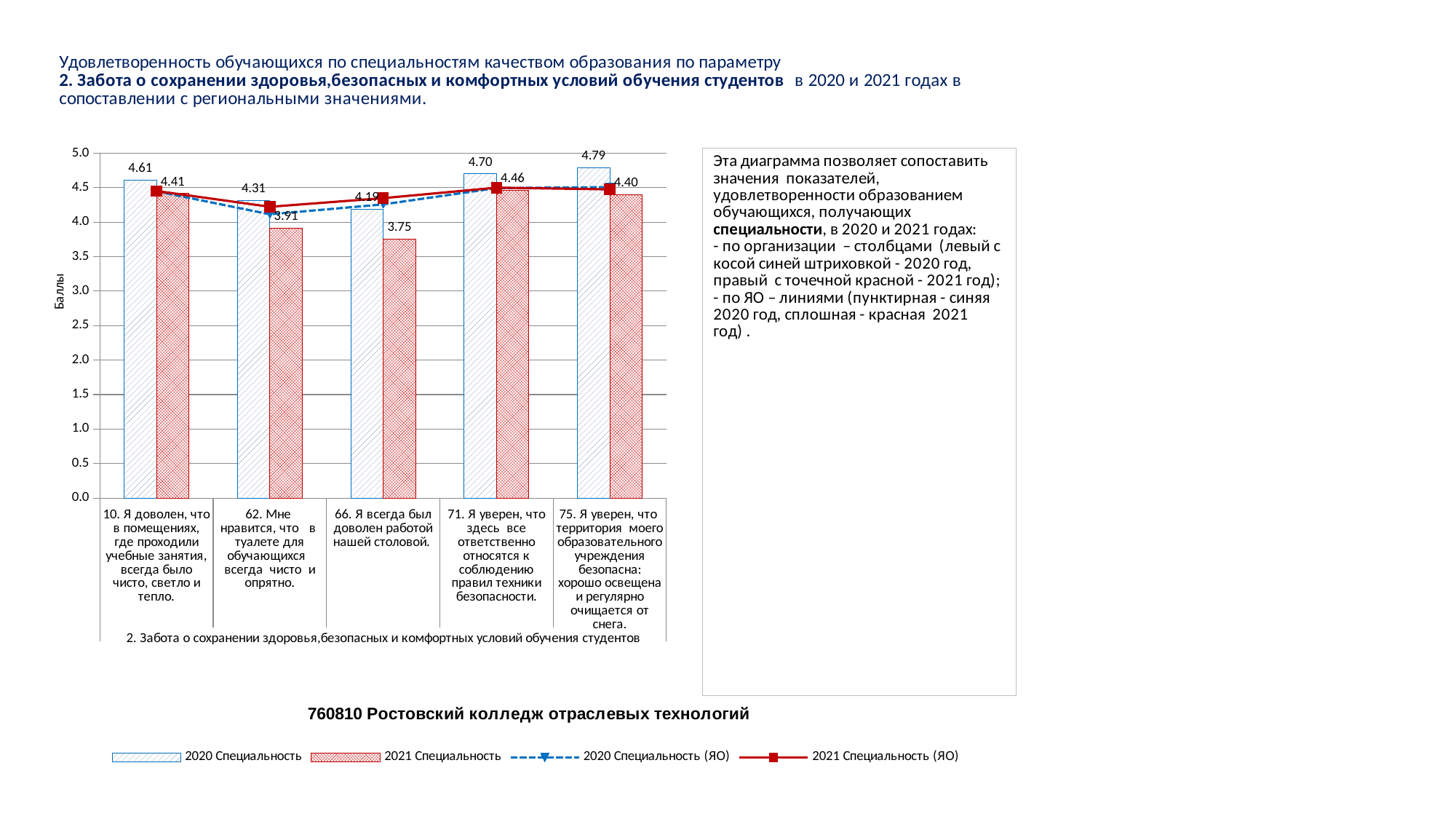
What is the label of the y axis? Баллы Which is larger for category 71: the 2020 Специальность value or the 2021 Специальность value? 2020 Специальность (4.70) Which category has the highest 2020 Специальность bar? 75. Я уверен, что территория моего образовательного учреждения безопасна: хорошо освещена и регулярно очищается от снега. What is the difference between the 2020 and 2021 Специальность values for category 75? 0.39 What is the 2021 Специальность value for category 66 (Я всегда был доволен работой нашей столовой)? 3.75 What is the 2021 Специальность value for category 62 (Мне нравится, что в туалете для обучающихся всегда чисто и опрятно)? 3.91 How many series does the legend list? 4 Is the 2021 Специальность (ЯО) line value for category 62 greater or less than 4.0? greater What is the 2020 Специальность value for category 10 (Я доволен, что в помещениях, где проходили учебные занятия, всегда было чисто, светло и тепло)? 4.61 Which category has the lowest 2021 Специальность bar? 66. Я всегда был доволен работой нашей столовой. What kind of chart is this? Combined bar and line chart How many categories are shown on the x axis? 5